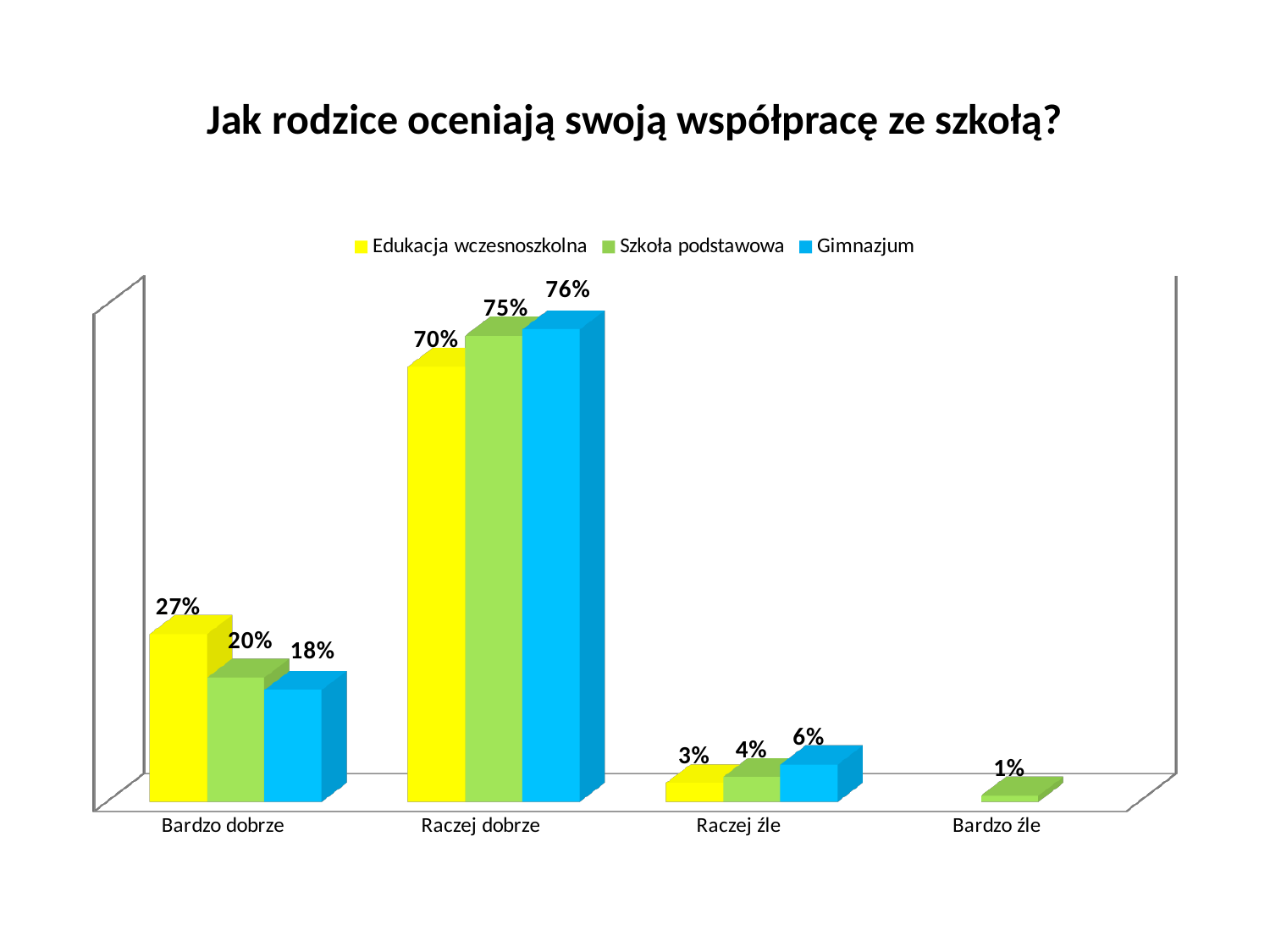
How many series does the legend list? 3 How many categories are shown on the x axis? 4 What is the value for Szkoła podstawowa in the Raczej dobrze category? 75% What is the difference between the Edukacja wczesnoszkolna and Gimnazjum values in the Bardzo dobrze category? 9% What kind of chart is shown on the slide? Bar chart What is the value for Szkoła podstawowa in the Bardzo źle category? 1% What is the value for Gimnazjum in the Bardzo dobrze category? 18% What is the title of the chart? Jak rodzice oceniają swoją współpracę ze szkołą? Which series has the highest value in the Raczej dobrze category? Gimnazjum Which series has the lowest value in the Bardzo dobrze category? Gimnazjum What is the value for Edukacja wczesnoszkolna in the Raczej źle category? 3% Which is larger: the Gimnazjum value for Raczej źle or the Szkoła podstawowa value for Raczej źle? Gimnazjum